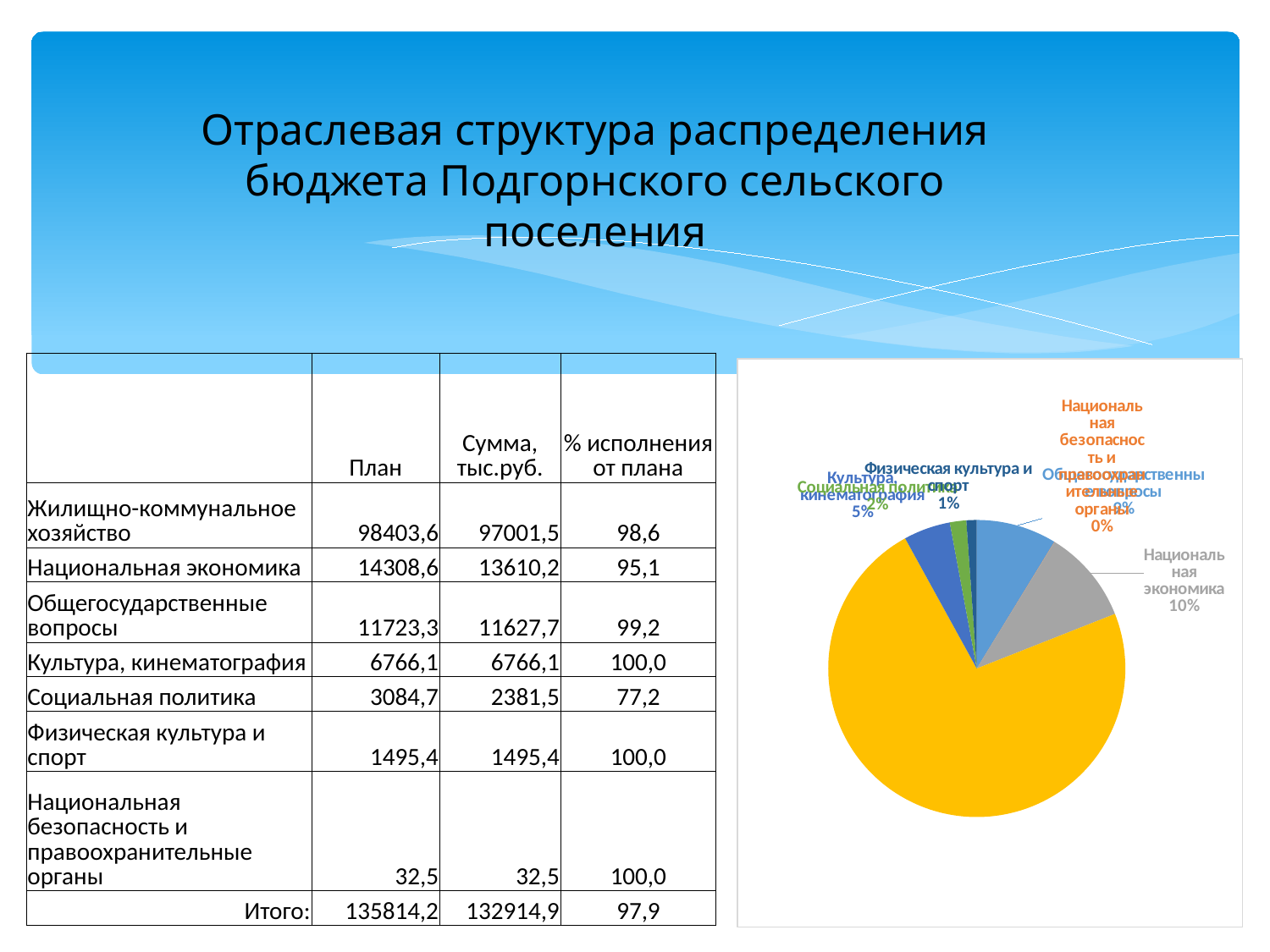
What colour is the largest slice of the pie? yellow Which has a smaller share, Физическая культура и спорт or Национальная безопасность и правоохранительные органы? Национальная безопасность и правоохранительные органы What percentage is shown for Национальная безопасность и правоохранительные органы? 0% What share of the pie does Национальная экономика have? 10% What percentage is shown for Физическая культура и спорт? 1% What colour is the slice for Национальная экономика? gray Which has a larger share of the pie, Национальная экономика or Физическая культура и спорт? Национальная экономика What kind of chart is shown on the slide? pie chart What is the difference between the shares of Национальная экономика and Физическая культура и спорт? 9%